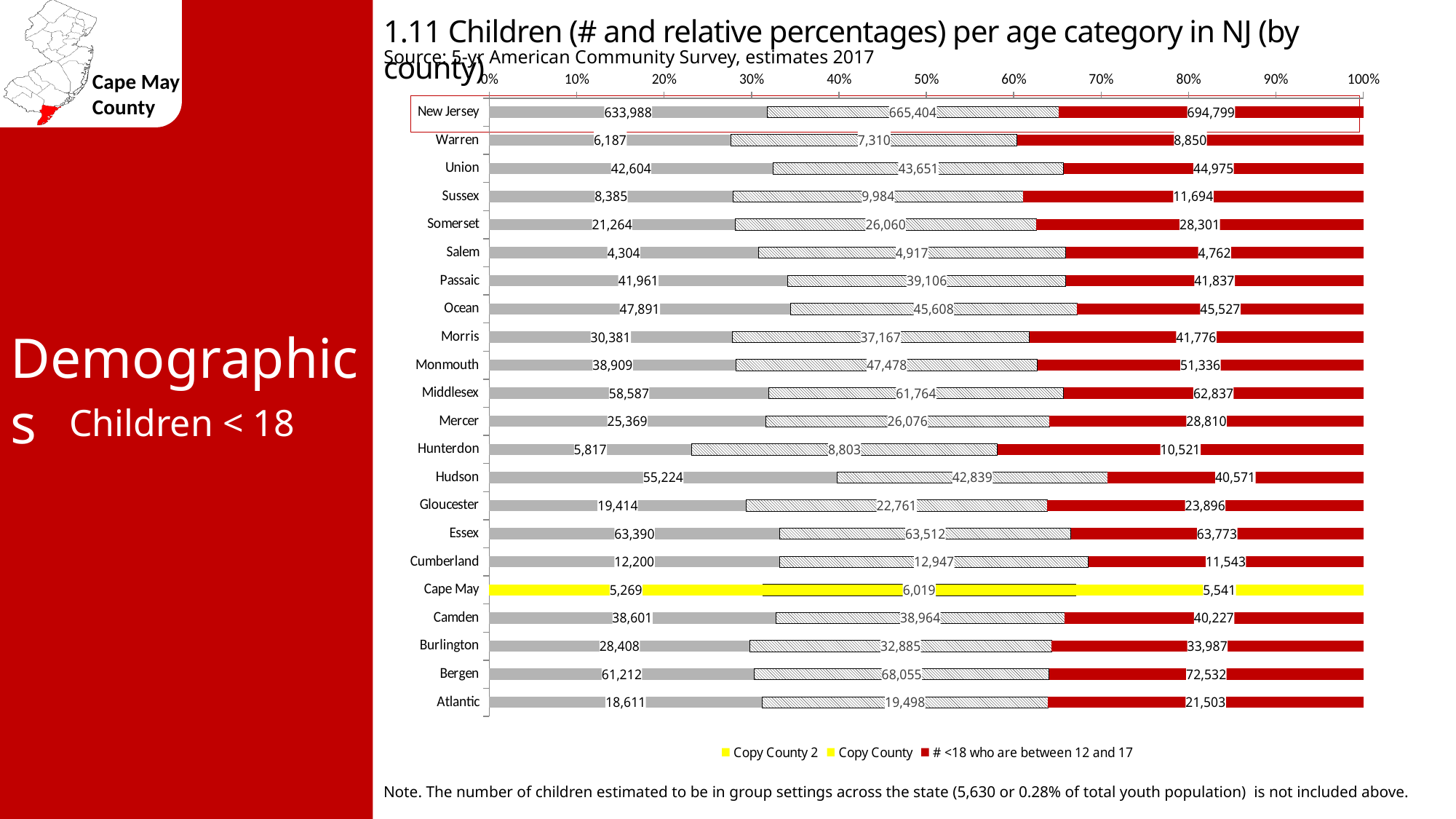
What kind of chart is shown on the slide? bar chart What is the value labelled on the first (leftmost) segment of the New Jersey bar? 633,988 Excluding the New Jersey row, which county has the lowest value for '# <18 who are between 12 and 17'? Salem What is the difference between the middle segment value (6,019) and the first segment value (5,269) for Cape May? 750 How many series does the chart legend list? 3 What is the value labelled on the first (leftmost) segment of the Hudson bar? 55,224 What is the value of the '# <18 who are between 12 and 17' segment for Cape May? 5,541 Which county's bar is highlighted in yellow on the chart? Cape May How many categories (rows) are plotted on the chart? 22 Which has the larger first-segment value, Hudson or Essex? Essex What is the value of the '# <18 who are between 12 and 17' segment for Warren? 8,850 What is the total of the three labelled values in the Cape May bar? 16,829